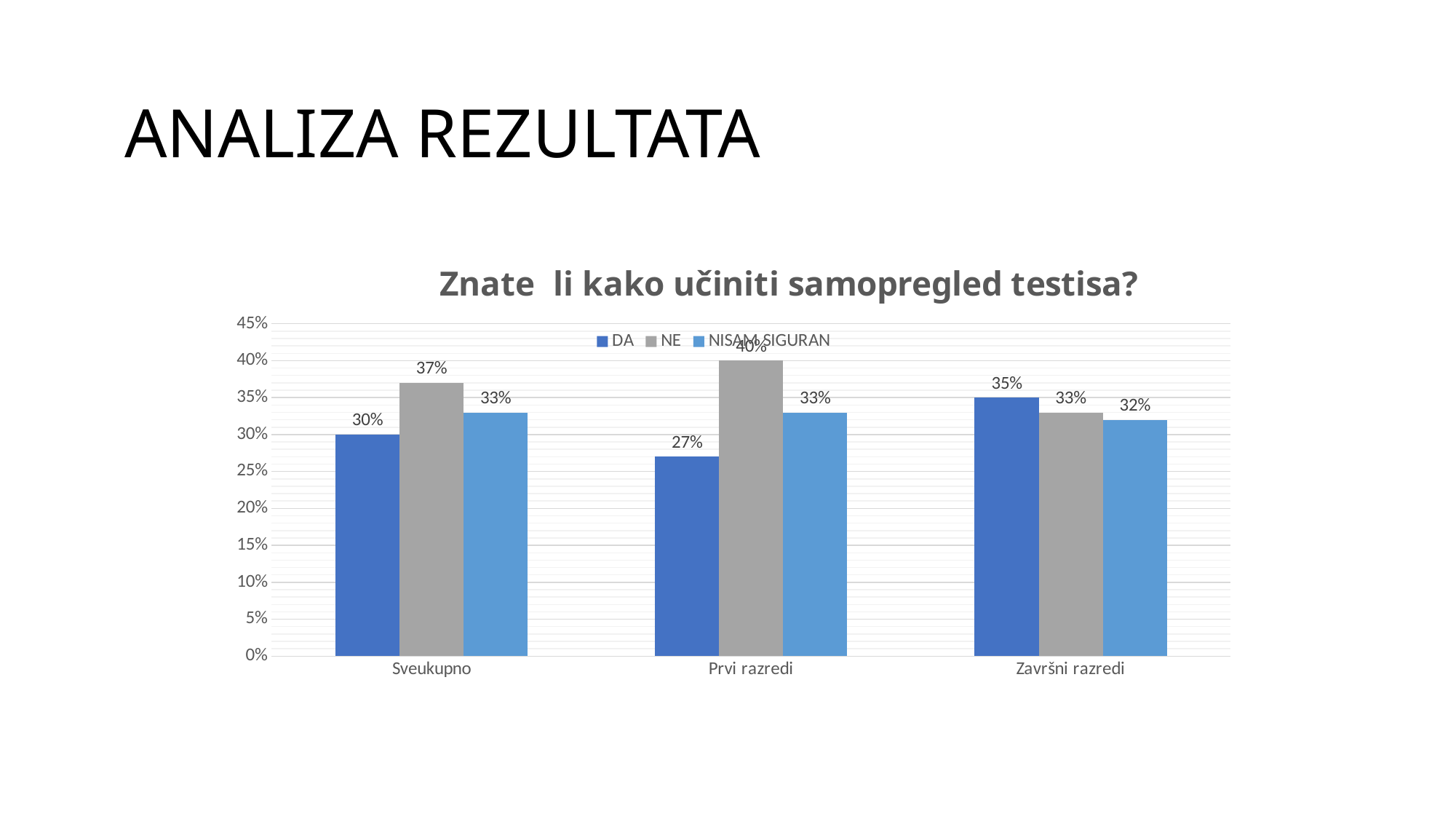
Which category has the lowest value for DA? Prvi razredi What is the difference between the NE and DA values in the Prvi razredi category? 13% Which is larger in the Završni razredi category, DA or NE? DA What kind of chart is shown on the slide? Bar chart How many categories are shown on the x axis? 3 What is the value for DA in the Sveukupno category? 30% What is the value for NE in the Prvi razredi category? 40% Which category has the highest value for NE? Prvi razredi What is the value for DA in the Završni razredi category? 35% How many series does the legend list? 3 What is the title of the chart? Znate li kako učiniti samopregled testisa? What is the value for NISAM SIGURAN in the Završni razredi category? 32%